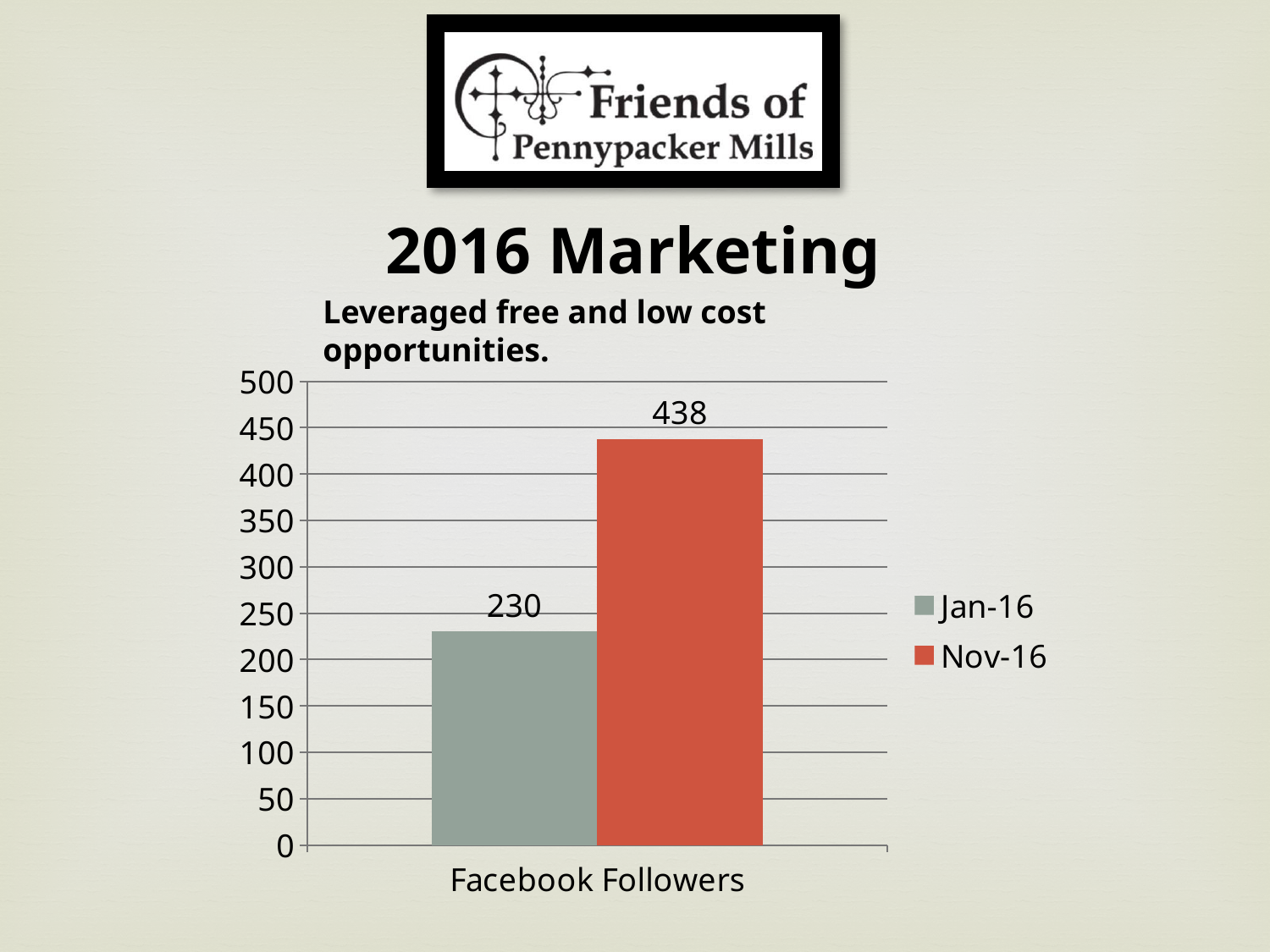
How many categories are shown on the x axis? 1 What colour is the Nov-16 bar in the chart? red What is the category label on the x axis of the chart? Facebook Followers What is the difference between the Nov-16 and Jan-16 Facebook Followers values? 208 Which series has the higher value for Facebook Followers, Jan-16 or Nov-16? Nov-16 What is the value for Nov-16 Facebook Followers? 438 Is the value for Nov-16 greater or less than 400? greater Which series has the lowest value for Facebook Followers? Jan-16 How many series does the legend list? 2 What kind of chart is shown on the slide? bar chart Is the value for Jan-16 greater or less than 250? less What is the value for Jan-16 Facebook Followers? 230